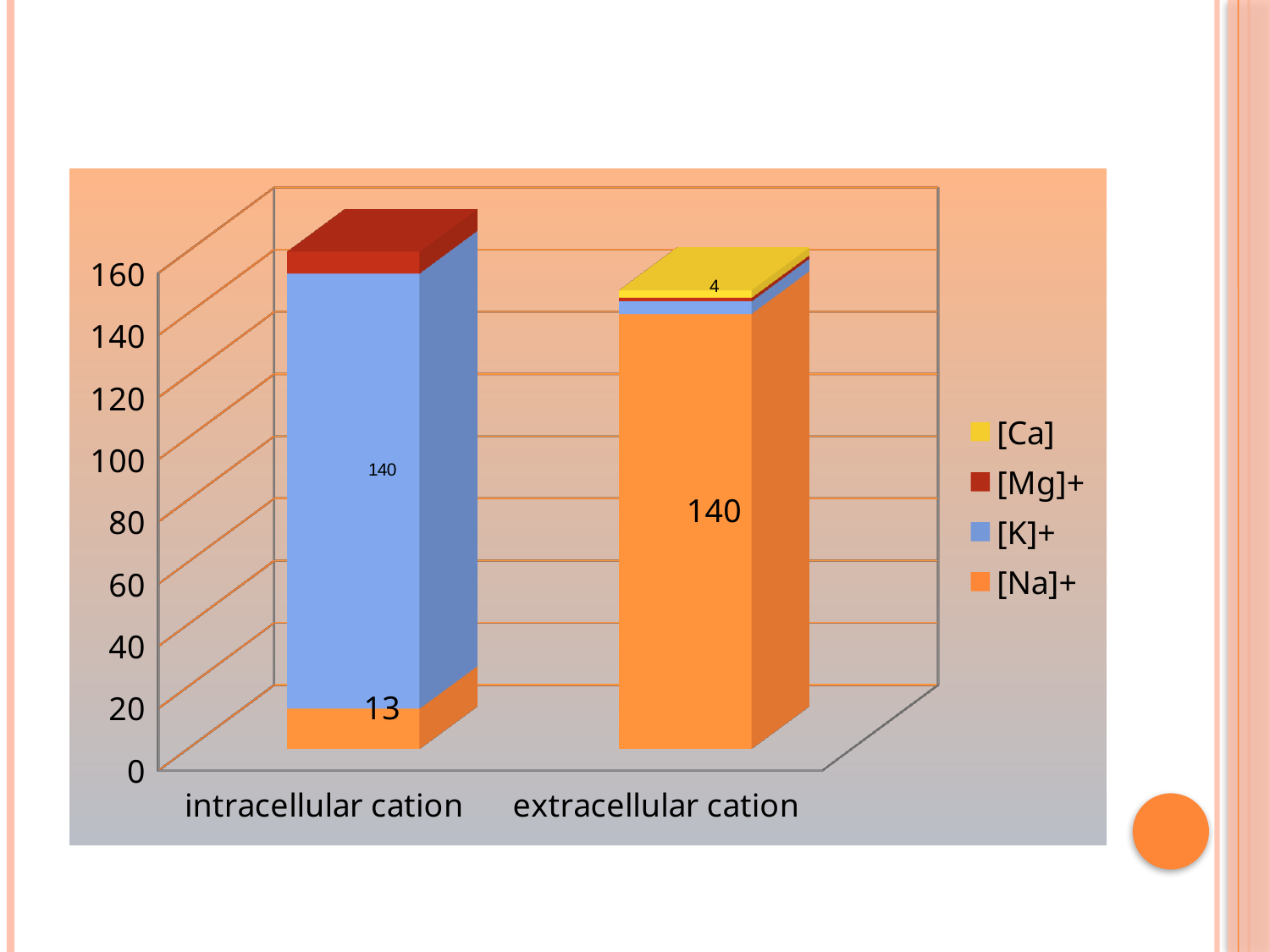
What is the difference between the [Na]+ value for extracellular cation and for intracellular cation? 127 What colour represents [Ca] in the legend? yellow Which is larger, the [Na]+ value for intracellular cation or for extracellular cation? extracellular cation What kind of chart is shown on the slide? stacked bar chart What is the value of [Na]+ for extracellular cation? 140 Is the [Na]+ value for intracellular cation greater or less than 20? less How many categories are shown on the x axis? 2 How many series does the legend list? 4 Within the intracellular cation bar, which series has the largest value? [K]+ What is the value of [K]+ for intracellular cation? 140 What is the value of [Na]+ for intracellular cation? 13